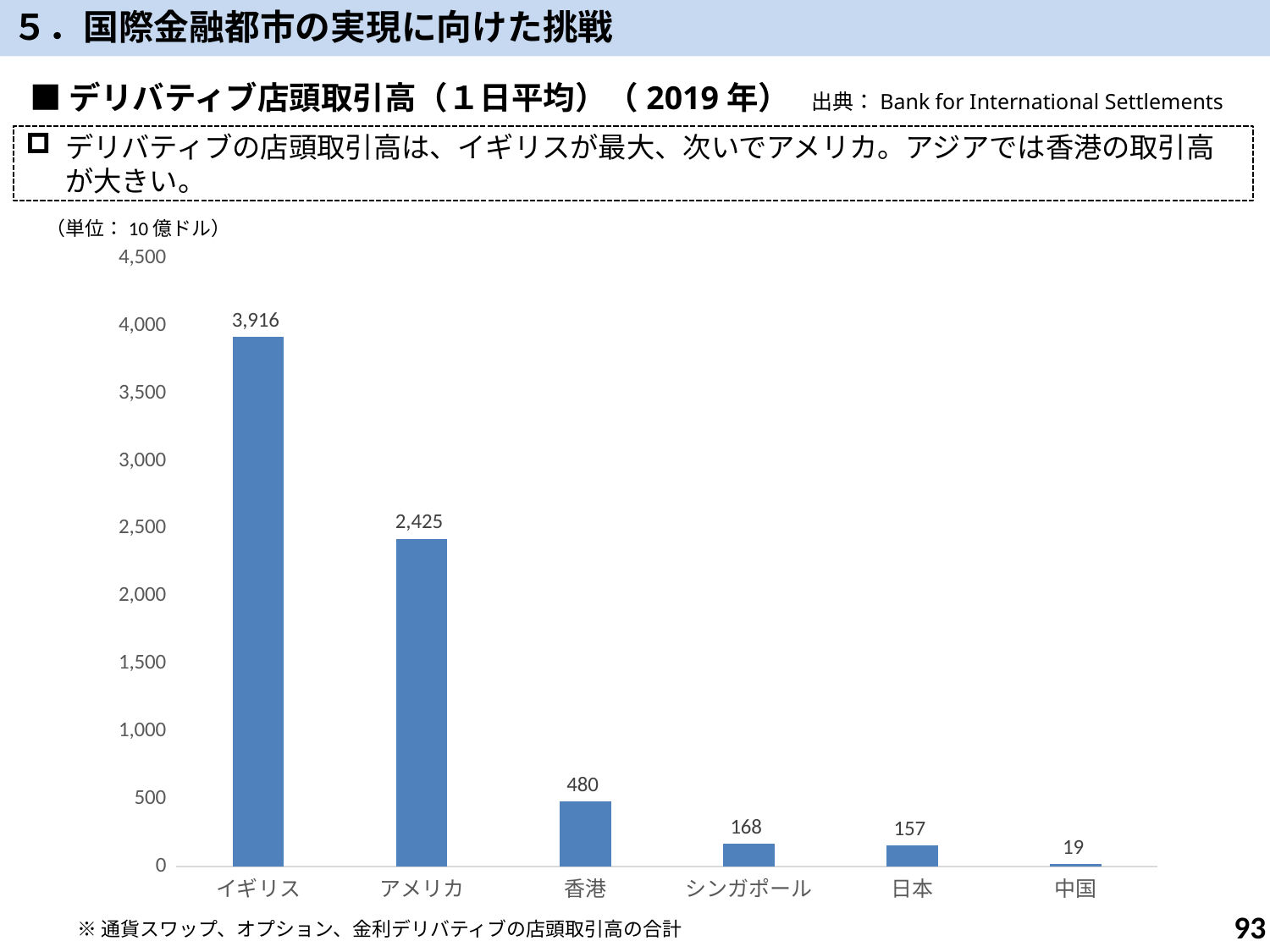
How many categories are shown on the x axis of the chart? 6 What is the difference between the values for シンガポール and 日本? 11 Is the value for アメリカ greater or less than 2,000? greater What kind of chart is shown on the slide? bar chart What is the value for 日本 (Japan) in the chart? 157 Which category has the highest value in the chart? イギリス What is the value for イギリス (UK) in the chart? 3,916 Which is larger, the value for 香港 or the value for シンガポール? 香港 Which category has the lowest value in the chart? 中国 What is the difference between the values for イギリス and アメリカ? 1,491 What is the value for 香港 (Hong Kong) in the chart? 480 What unit is stated for the values in the chart? 10億ドル